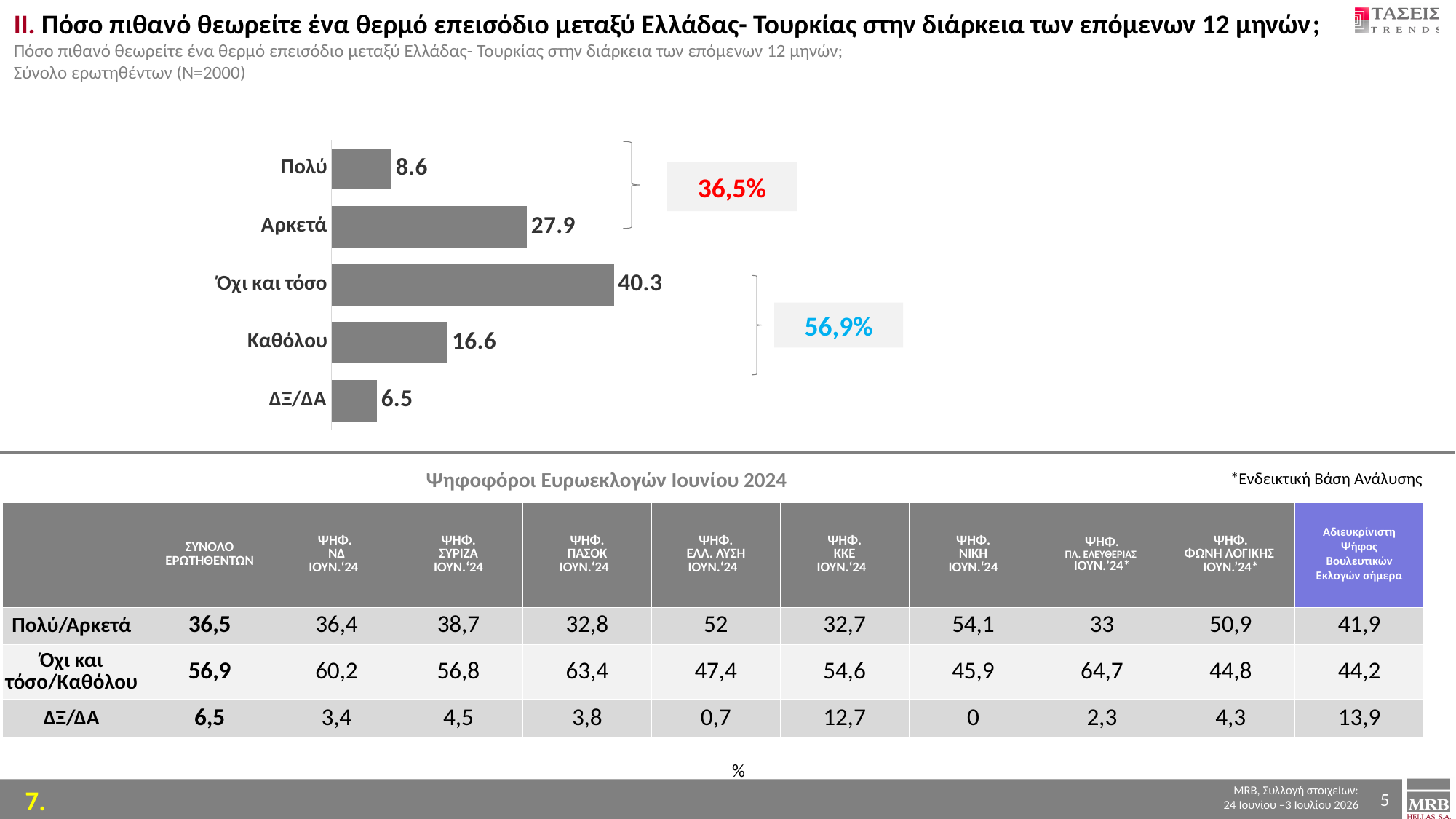
Which is larger, the value for 'Καθόλου' or the value for 'Πολύ'? Καθόλου What combined percentage is shown in blue next to the bracket grouping 'Όχι και τόσο' and 'Καθόλου'? 56,9% What is the difference between the values for 'Όχι και τόσο' and 'Αρκετά'? 12.4 What combined percentage is shown in red next to the bracket grouping 'Πολύ' and 'Αρκετά'? 36,5% What value is shown for the bar labelled 'Όχι και τόσο'? 40.3 What type of chart is shown on the slide? Bar chart How many bars are plotted in the chart? 5 What value is shown for the bar labelled 'Πολύ'? 8.6 Which category has the highest value in the bar chart? Όχι και τόσο Which category has the lowest value in the bar chart? ΔΞ/ΔΑ What value is shown for the bar labelled 'Καθόλου'? 16.6 What value is shown for the bar labelled 'Αρκετά'? 27.9